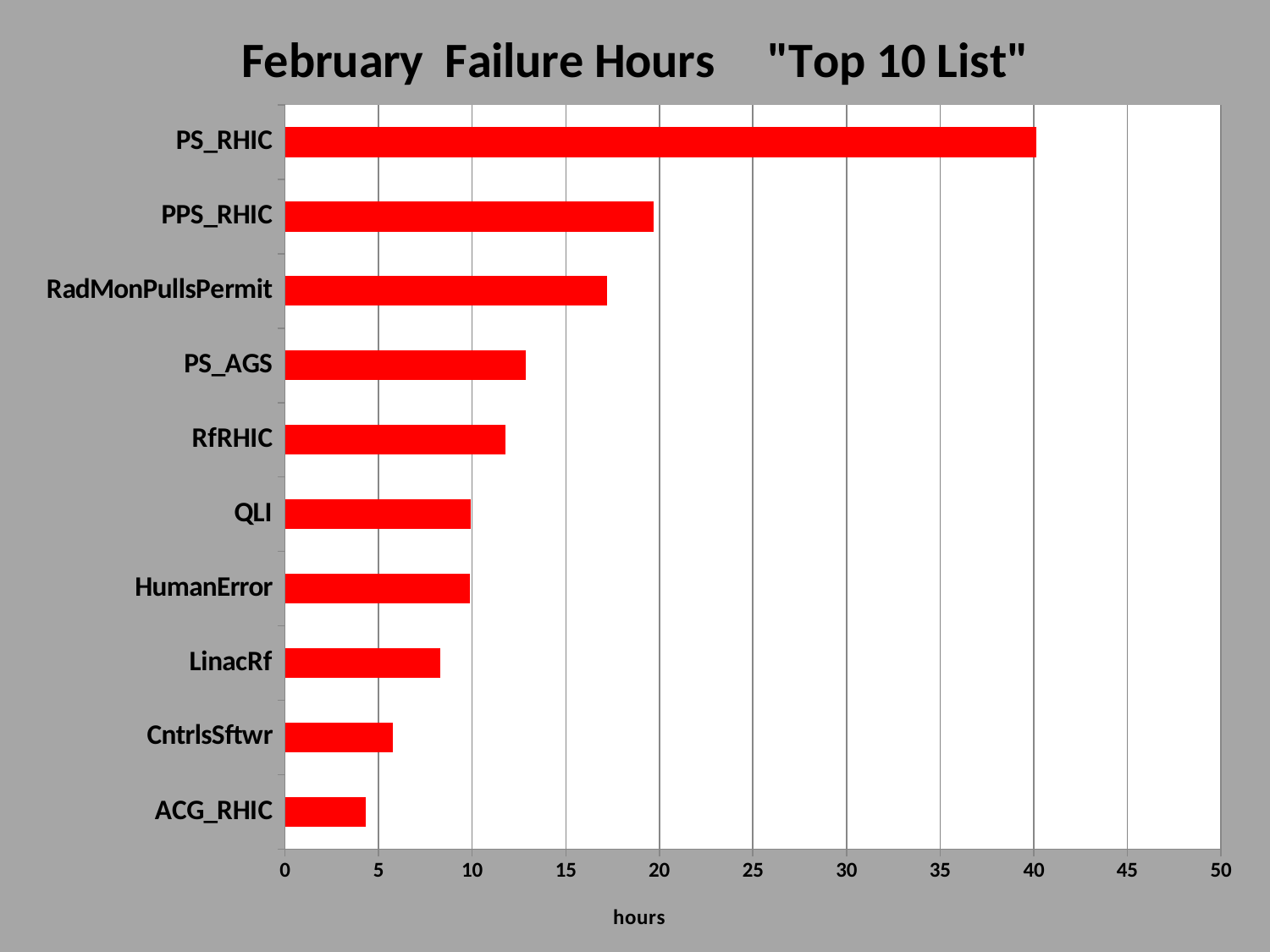
Which category has the highest failure hours? PS_RHIC What is the title of the chart? February Failure Hours "Top 10 List" Is the value for ACG_RHIC greater or less than 5? less What is the label on the horizontal axis? hours Is the value for PPS_RHIC greater or less than 15? greater What kind of chart is shown on the slide? bar chart Which category has the lowest failure hours? ACG_RHIC Is the value for LinacRf greater or less than 10? less Which has more failure hours, RadMonPullsPermit or PS_AGS? RadMonPullsPermit How many categories are plotted in the chart? 10 Which has more failure hours, PS_RHIC or PPS_RHIC? PS_RHIC